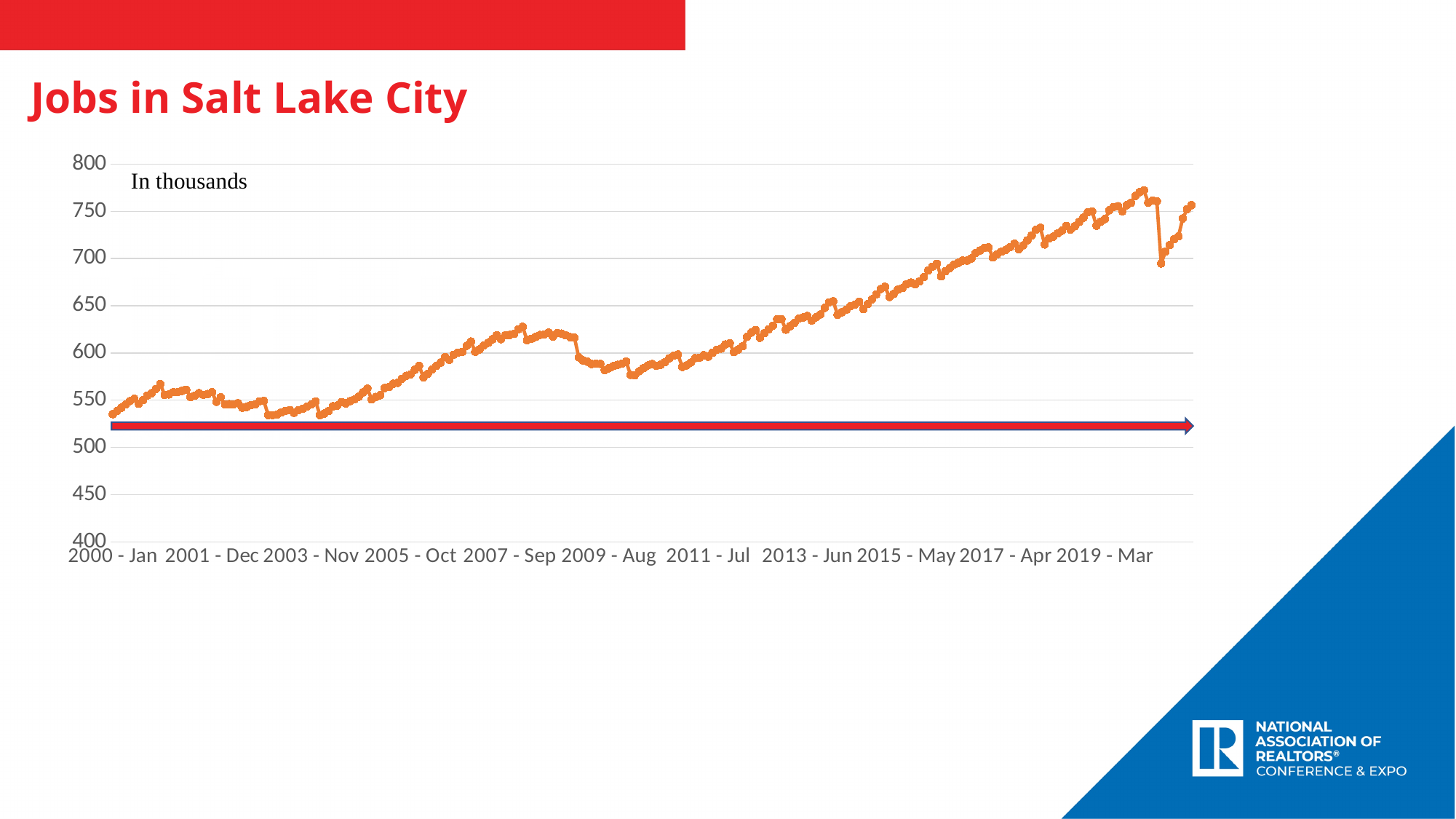
Overall, do the values rise or fall from 2000 - Jan to 2019 - Mar? Rise Is the highest point on the line greater or less than 750? greater Which is larger, the value for 2019 - Mar or the value for 2000 - Jan? 2019 - Mar How many date labels are shown along the x axis? 11 Is the value for 2009 - Aug greater or less than 600? less What kind of chart is shown on the slide? Line chart Is the value for 2000 - Jan greater or less than 550? less In what units are the values on the chart expressed, according to the note on the chart? In thousands Which is larger, the value for 2007 - Sep or the value for 2009 - Aug? 2007 - Sep What is the title of the chart? Jobs in Salt Lake City